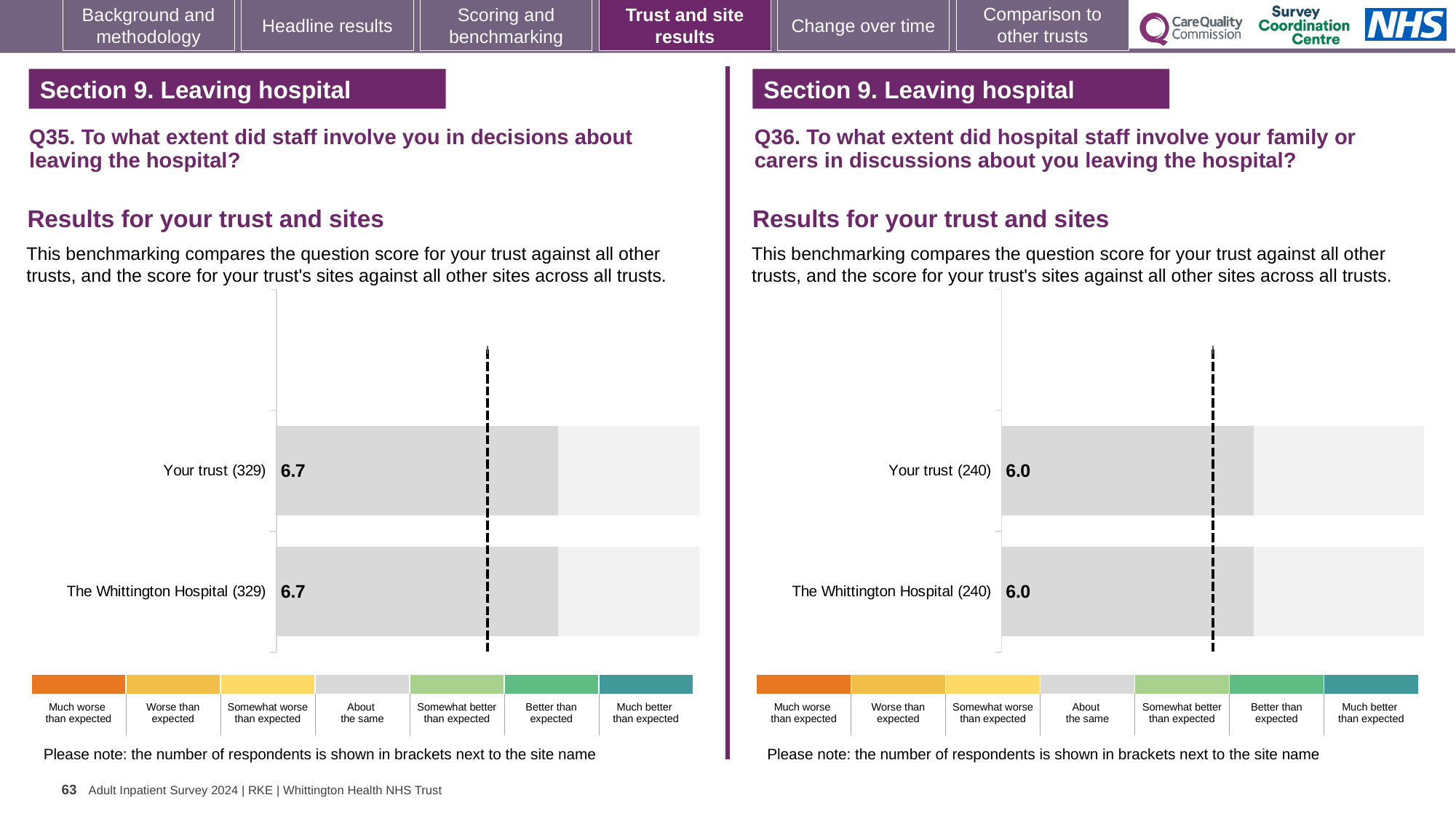
Which is larger: the Your trust score in the Q35 chart on the left or the Your trust score in the Q36 chart on the right? Q35 chart (6.7) What kind of chart is used for the Q35 results on the left? Bar chart In the Q36 chart on the right, how many respondents are shown in brackets next to Your trust? 240 In the Q35 chart on the left, what is the score for The Whittington Hospital (329)? 6.7 What is the difference between the Your trust score in the Q35 chart on the left and the Your trust score in the Q36 chart on the right? 0.7 In the Q36 chart on the right, what is the score for The Whittington Hospital (240)? 6.0 How many bars are plotted in the Q35 chart on the left? 2 In the Q35 chart on the left, what is the score for Your trust (329)? 6.7 How many categories does the colour key below the Q35 chart on the left list? 7 How many bars are plotted in the Q36 chart on the right? 2 In the Q36 chart on the right, what is the score for Your trust (240)? 6.0